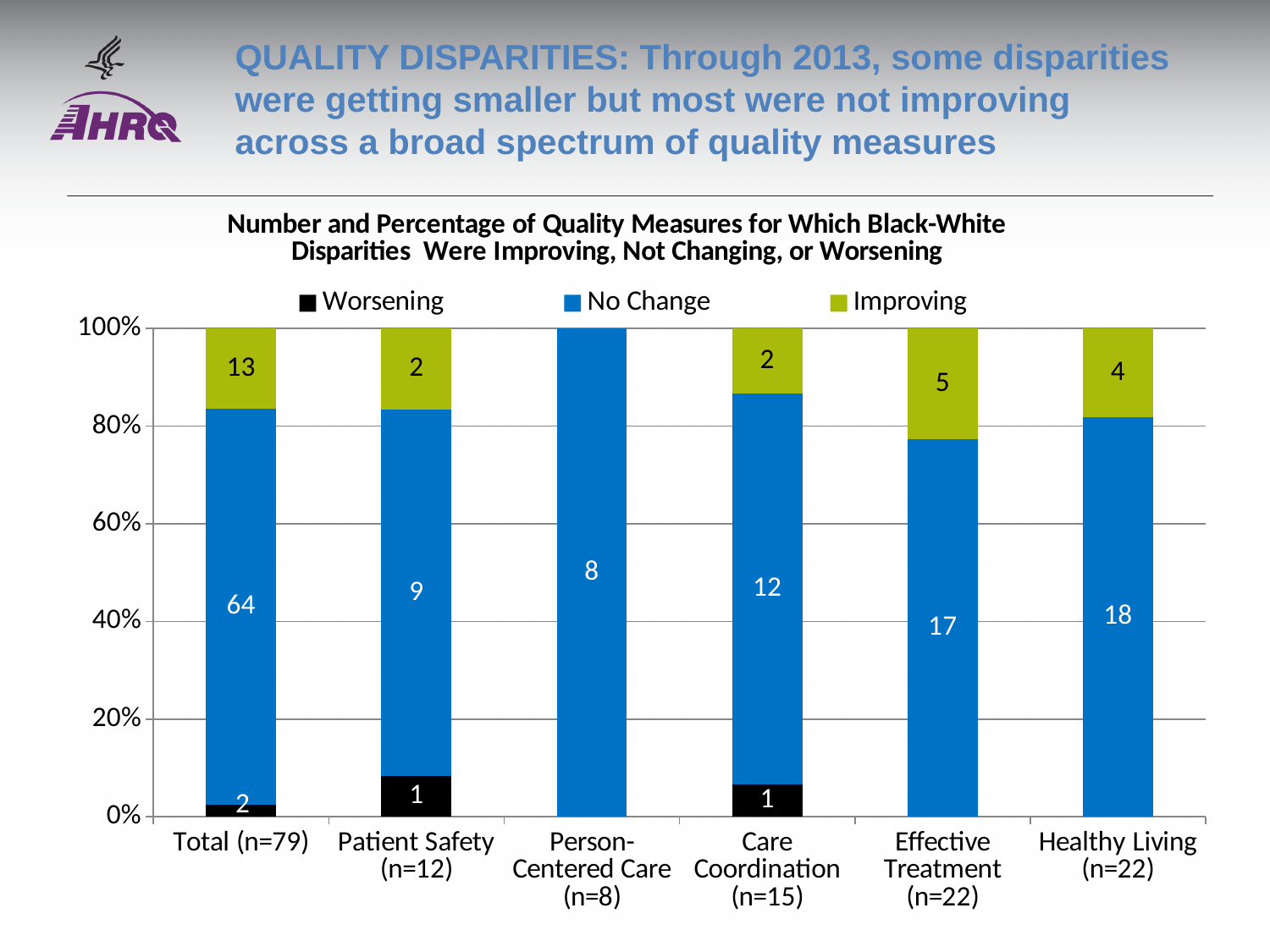
Which category has the highest No Change value? Total (n=79) Excluding Total, which category has the lowest No Change value? Person-Centered Care (n=8) How many series does the legend list? 3 What is the number of No Change measures for Total (n=79)? 64 What is the difference between the No Change values for Healthy Living (n=22) and Effective Treatment (n=22)? 1 What kind of chart is shown on the slide? Stacked bar chart Which is larger: the Improving value for Effective Treatment (n=22) or for Healthy Living (n=22)? Effective Treatment (n=22) What is the Worsening value for Care Coordination (n=15)? 1 How many Improving measures are shown for Effective Treatment (n=22)? 5 How many categories are shown on the x axis? 6 What is the total of the Worsening, No Change and Improving values for Patient Safety (n=12)? 12 Is the No Change share of the Effective Treatment (n=22) bar greater or less than 80%? less